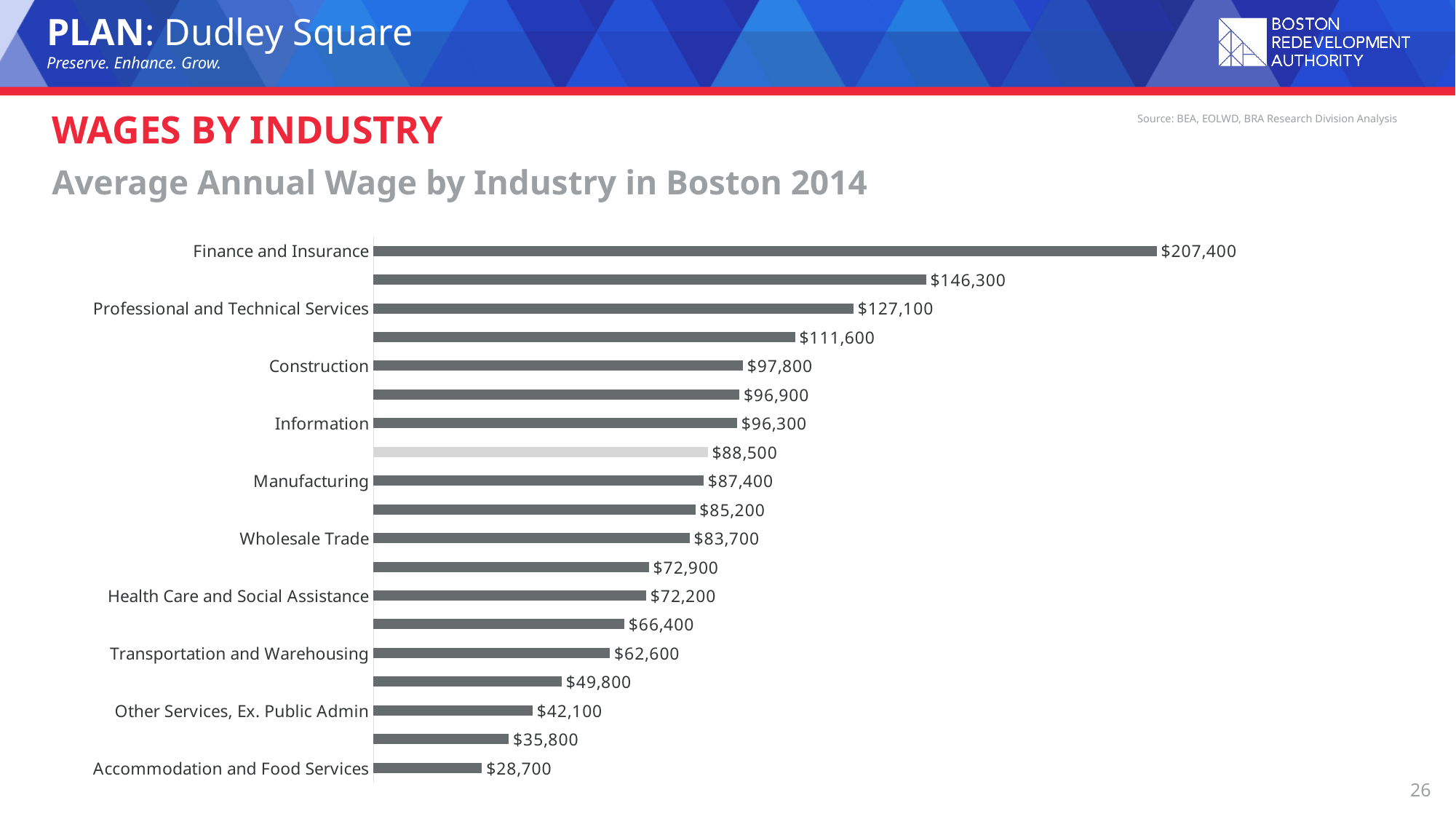
What is the difference between the average annual wage for Finance and Insurance and for Professional and Technical Services? $80,300 Which industry has the lowest average annual wage? Accommodation and Food Services What is the difference between the average annual wage for Construction and for Information? $1,500 What value is labelled on the single light grey bar in the chart? $88,500 What is the average annual wage for Professional and Technical Services? $127,100 What kind of chart is shown on the slide? Bar chart What is the average annual wage for Health Care and Social Assistance? $72,200 Which industry has the highest average annual wage? Finance and Insurance What is the average annual wage for Accommodation and Food Services? $28,700 How many bars are plotted in the chart? 19 Which has a higher average annual wage, Manufacturing or Wholesale Trade? Manufacturing What is the average annual wage for Finance and Insurance? $207,400